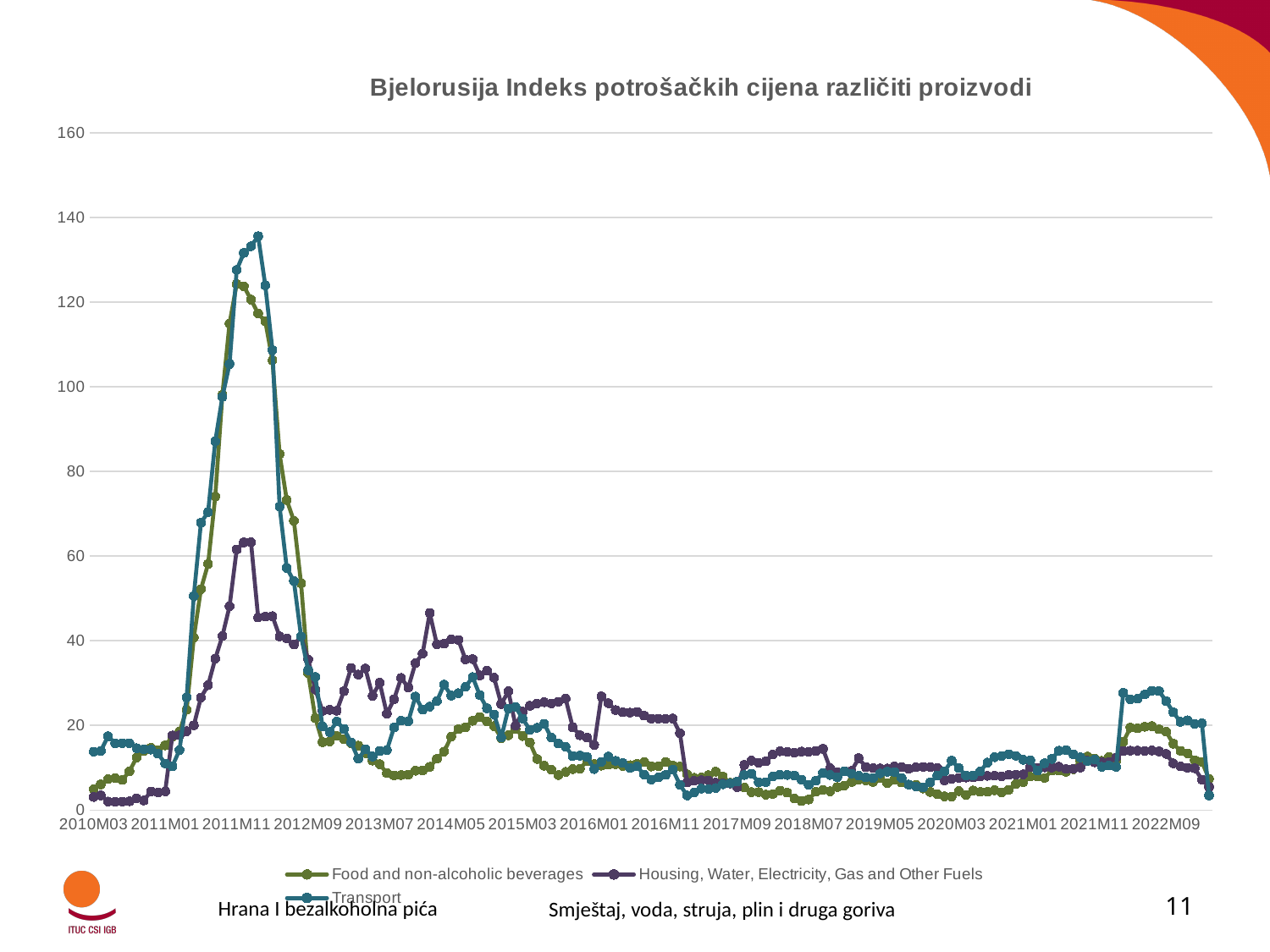
Which series reaches the highest peak on the chart? Transport What is the title of the chart? Bjelorusija Indeks potrošačkih cijena različiti proizvodi Around 2014M05, which series is higher: Housing, Water, Electricity, Gas and Other Fuels or Food and non-alcoholic beverages? Housing, Water, Electricity, Gas and Other Fuels Which series has the lowest peak on the chart? Housing, Water, Electricity, Gas and Other Fuels Is the peak value of the Housing, Water, Electricity, Gas and Other Fuels series greater or less than 80? less Is the peak value of the Food and non-alcoholic beverages series greater or less than 100? greater What is the highest value shown on the vertical axis? 160 Is the peak value of the Transport series greater or less than 120? greater What kind of chart is shown on the slide? line chart After the peak around 2011M11, do the values of the Transport series rise or fall over the following year? fall How many series does the legend list? 3